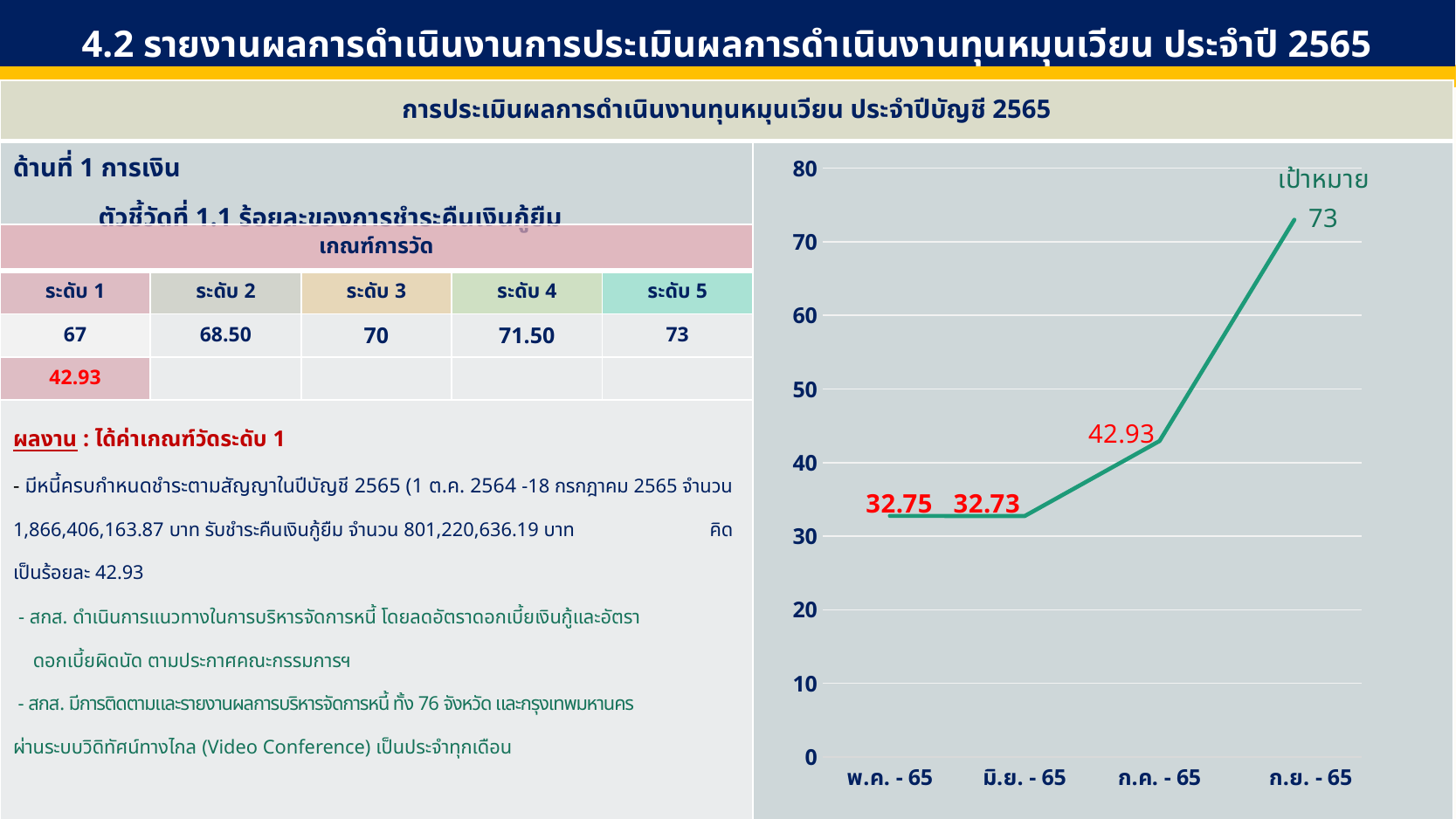
Is the value for ก.ค. - 65 greater or less than 50? less Which x-axis category has the highest plotted value? ก.ย. - 65 What is the difference between the value for ก.ย. - 65 and the value for ก.ค. - 65? 30.07 Which is larger, the value for ก.ค. - 65 or the value for มิ.ย. - 65? ก.ค. - 65 What is the value plotted for ก.ค. - 65? 42.93 What type of chart is shown on the right side of the slide? line chart How many points are plotted along the x axis of the line chart? 4 What label is written above the last point of the line chart? เป้าหมาย What is the value plotted for พ.ค. - 65? 32.75 What is the difference between the value for ก.ค. - 65 and the value for พ.ค. - 65? 10.18 What is the value plotted for มิ.ย. - 65? 32.73 What is the value plotted for ก.ย. - 65? 73